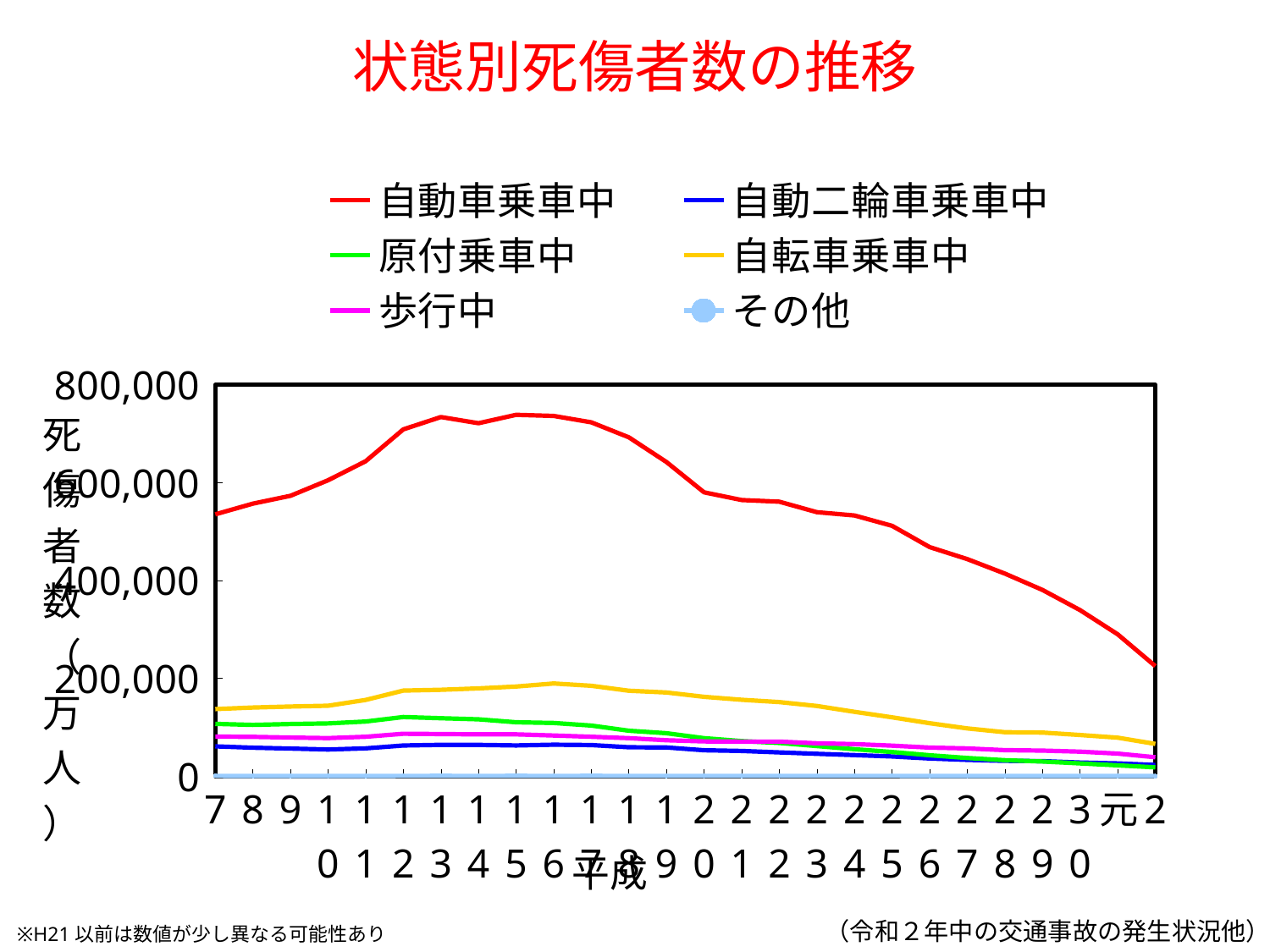
How many years are plotted along the x axis? 26 How many series does the legend list? 6 Which series has the highest values across the whole period? 自動車乗車中 What kind of chart is shown on the slide? line chart Is the value for 自動車乗車中 in 平成7 greater or less than 400,000? greater Is the value for 自動車乗車中 in 令和2 greater or less than 400,000? less Is the value for 自転車乗車中 in 平成16 greater or less than 100,000? greater In 平成7, which is larger: 原付乗車中 or 自動二輪車乗車中? 原付乗車中 In 平成16, which is larger: 自転車乗車中 or 歩行中? 自転車乗車中 What is the title of the chart? 状態別死傷者数の推移 Which series has the lowest values across the whole period? その他 Does the 自動車乗車中 series rise or fall from 平成16 to 令和2? fall